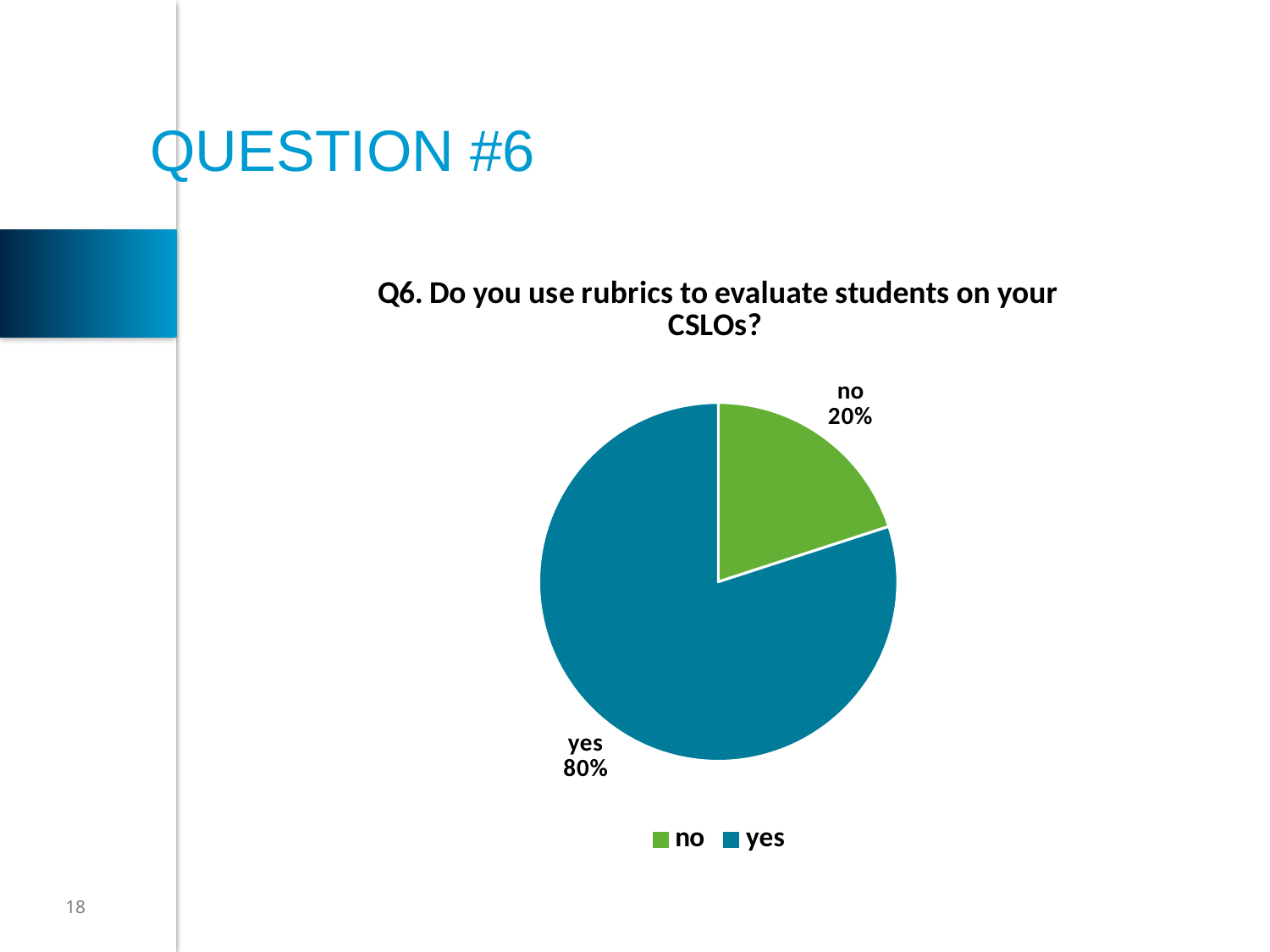
What share of the pie does the "yes" slice represent? 80% What is the difference in percentage points between the "yes" and "no" slices? 60 How many entries does the legend list? 2 How many slices does the pie chart have? 2 What share of the pie does the "no" slice represent? 20% What colour is the "no" slice in the pie chart? green What is the title of the chart? Q6. Do you use rubrics to evaluate students on your CSLOs? Which is larger, the "yes" slice or the "no" slice? yes Which slice of the pie is the smallest? no Which slice of the pie is the largest? yes What kind of chart is shown on the slide? pie chart